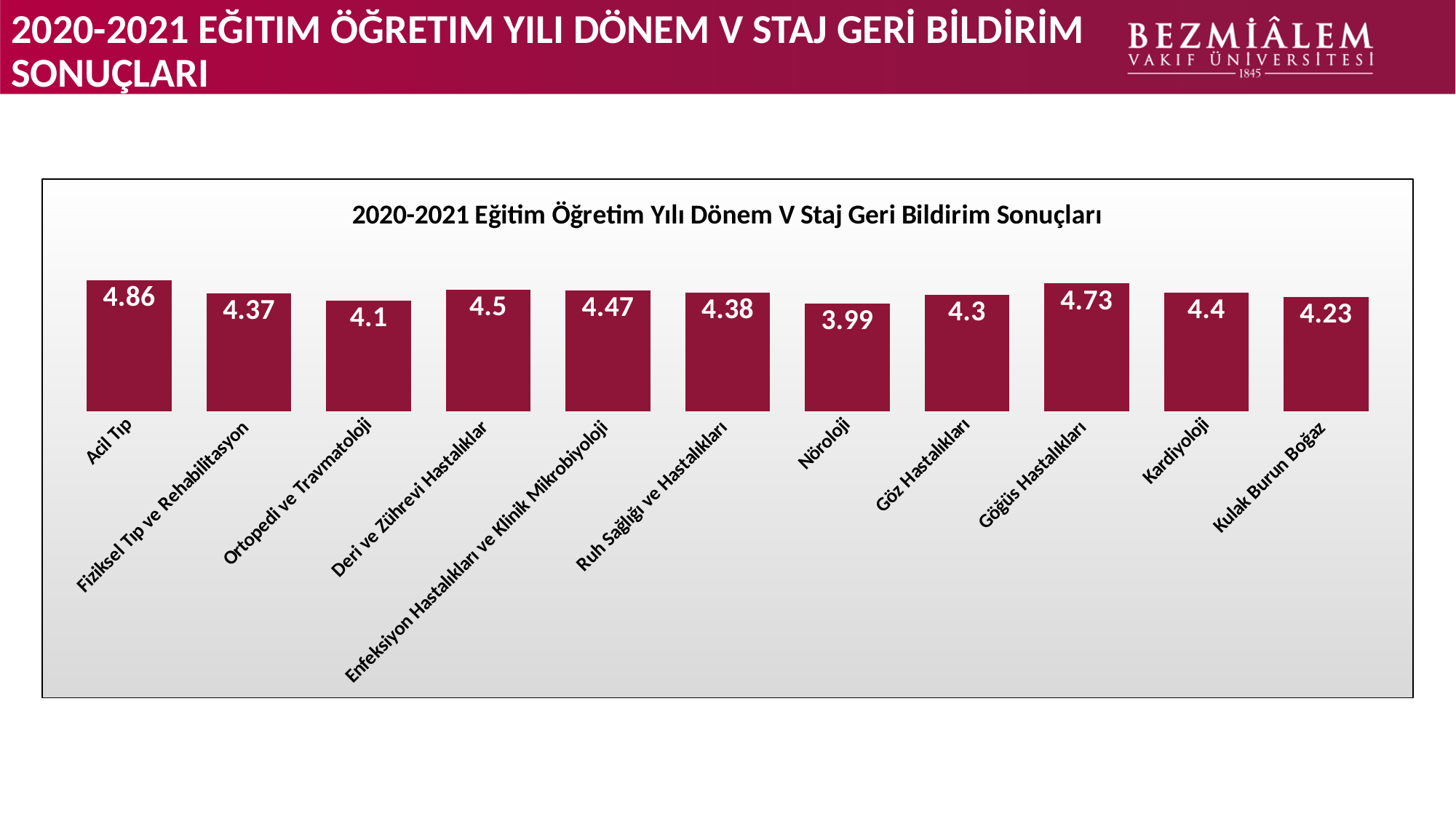
What is the value for Göğüs Hastalıkları? 4.73 What is the value for Acil Tıp? 4.86 Which has a larger value, Deri ve Zührevi Hastalıklar or Ortopedi ve Travmatoloji? Deri ve Zührevi Hastalıklar What is the difference between the values for Göğüs Hastalıkları and Kardiyoloji? 0.33 Which category has the lowest value? Nöroloji How many categories are shown in the chart? 11 Which category has the highest value? Acil Tıp What is the value for Nöroloji? 3.99 What is the difference between the values for Acil Tıp and Nöroloji? 0.87 What is the value for Kulak Burun Boğaz? 4.23 What is the title of the chart? 2020-2021 Eğitim Öğretim Yılı Dönem V Staj Geri Bildirim Sonuçları What kind of chart is shown on the slide? Bar chart